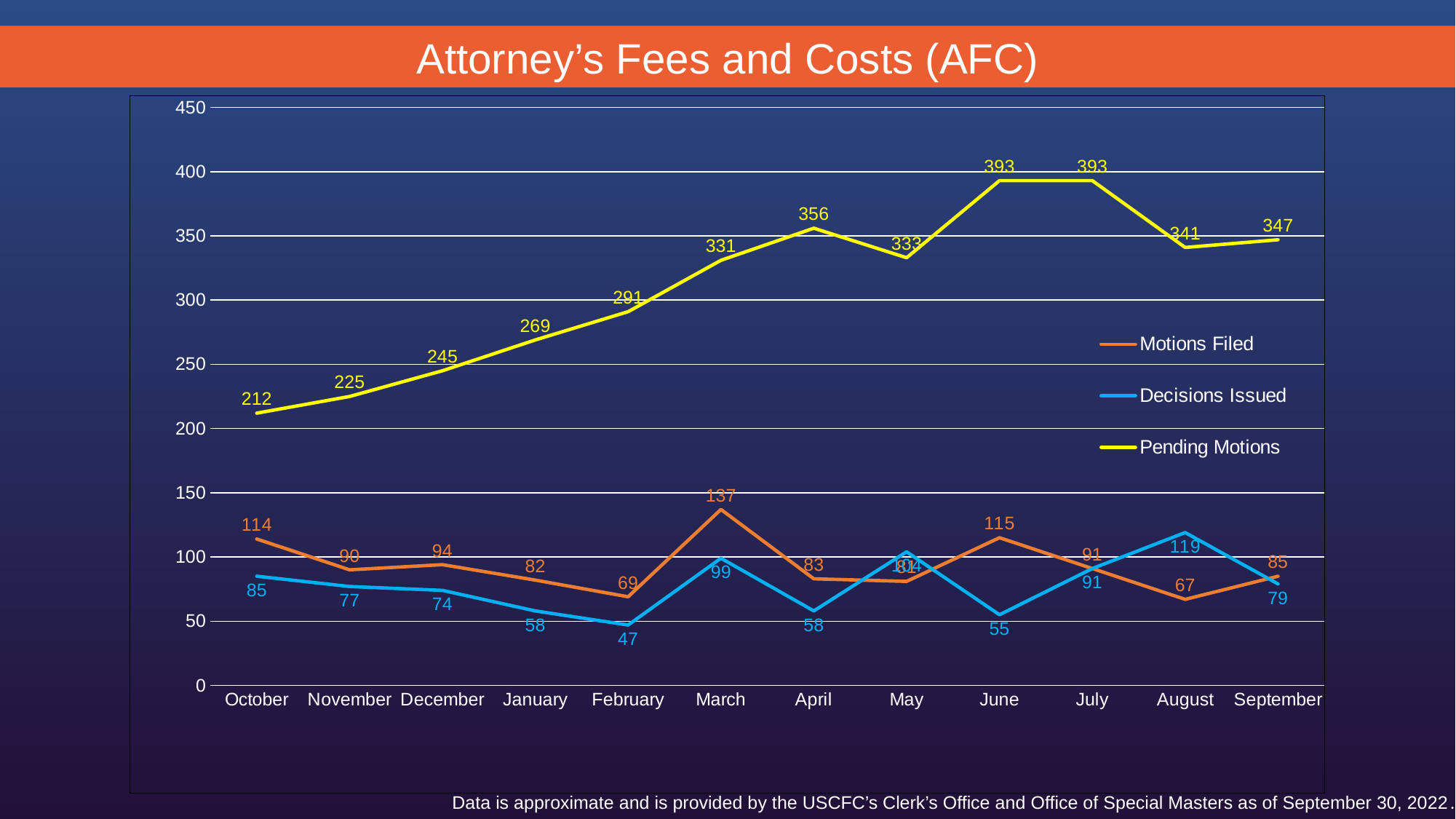
What is the value of Decisions Issued in February? 47 What is the difference between Pending Motions in June and in October? 181 How many months are shown on the x axis? 12 How many Motions Filed are shown for March? 137 What is the value of Pending Motions in April? 356 What kind of chart is shown on the slide? line chart In which month is the Motions Filed value highest? March In which month is the Decisions Issued value lowest? February Is the value for Pending Motions in March greater or less than 300? greater In which month is the Pending Motions value lowest? October How many series does the legend list? 3 Which is larger: Decisions Issued in August or Decisions Issued in October? August